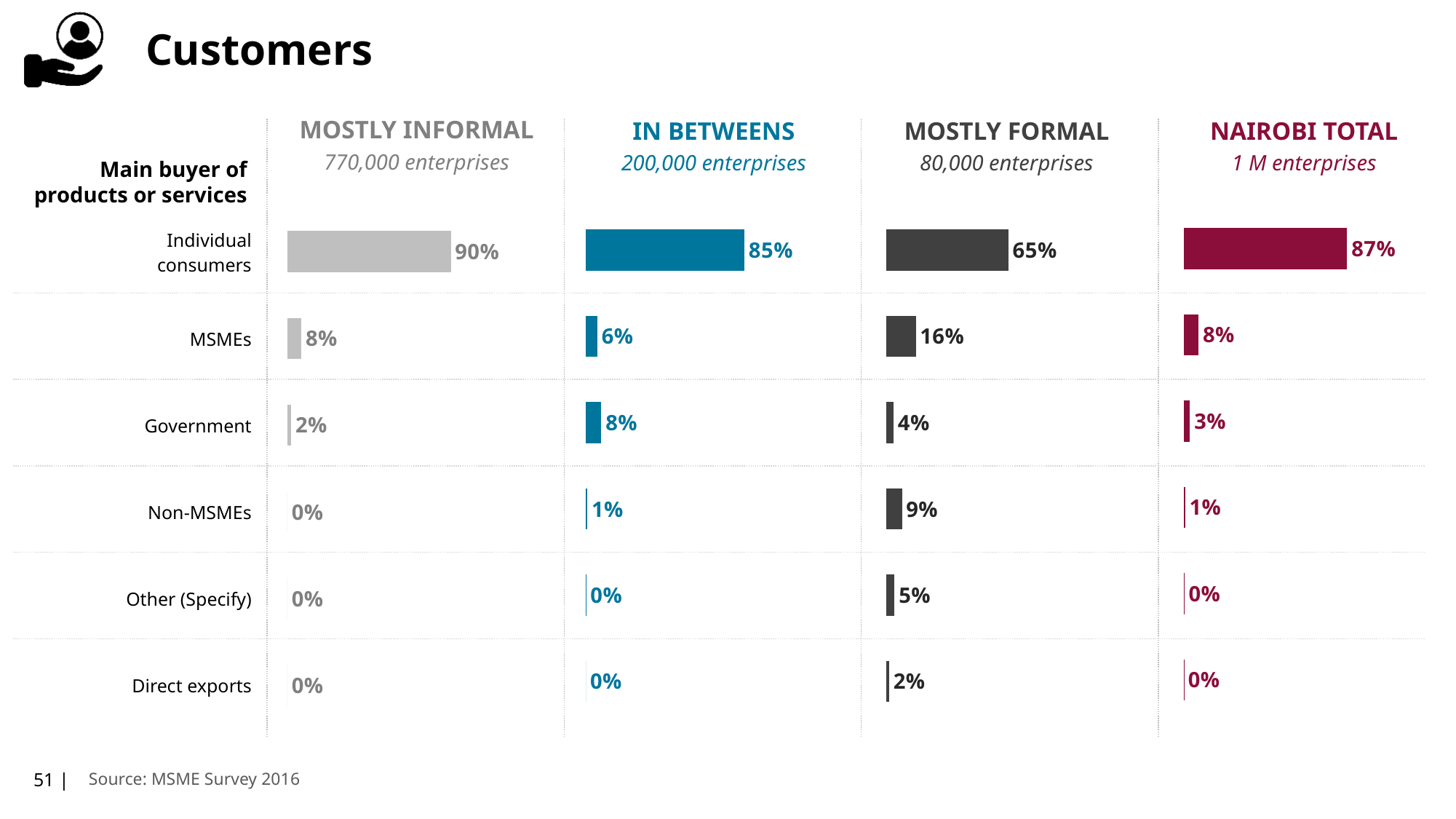
How many main buyer categories are listed in each chart? 6 What type of chart is used to show the main buyer of products or services? Bar chart In the Mostly Formal chart, what is the difference between Individual consumers and MSMEs? 49% In the Mostly Informal chart, what percentage of enterprises have individual consumers as their main buyer? 90% Which is larger: the MSMEs value in the Mostly Formal chart or the MSMEs value in the In Betweens chart? Mostly Formal In the In Betweens chart, what is the value for Government? 8% How many enterprises does the In Betweens column represent? 200,000 enterprises In the Mostly Informal chart, what is the difference between Individual consumers and MSMEs? 82% In the Nairobi Total chart, what is the value for Individual consumers? 87% In the Mostly Formal chart, what is the value for MSMEs? 16% In the Mostly Formal chart, what is the value for Non-MSMEs? 9% In the Mostly Formal chart, which main buyer category has the highest value? Individual consumers